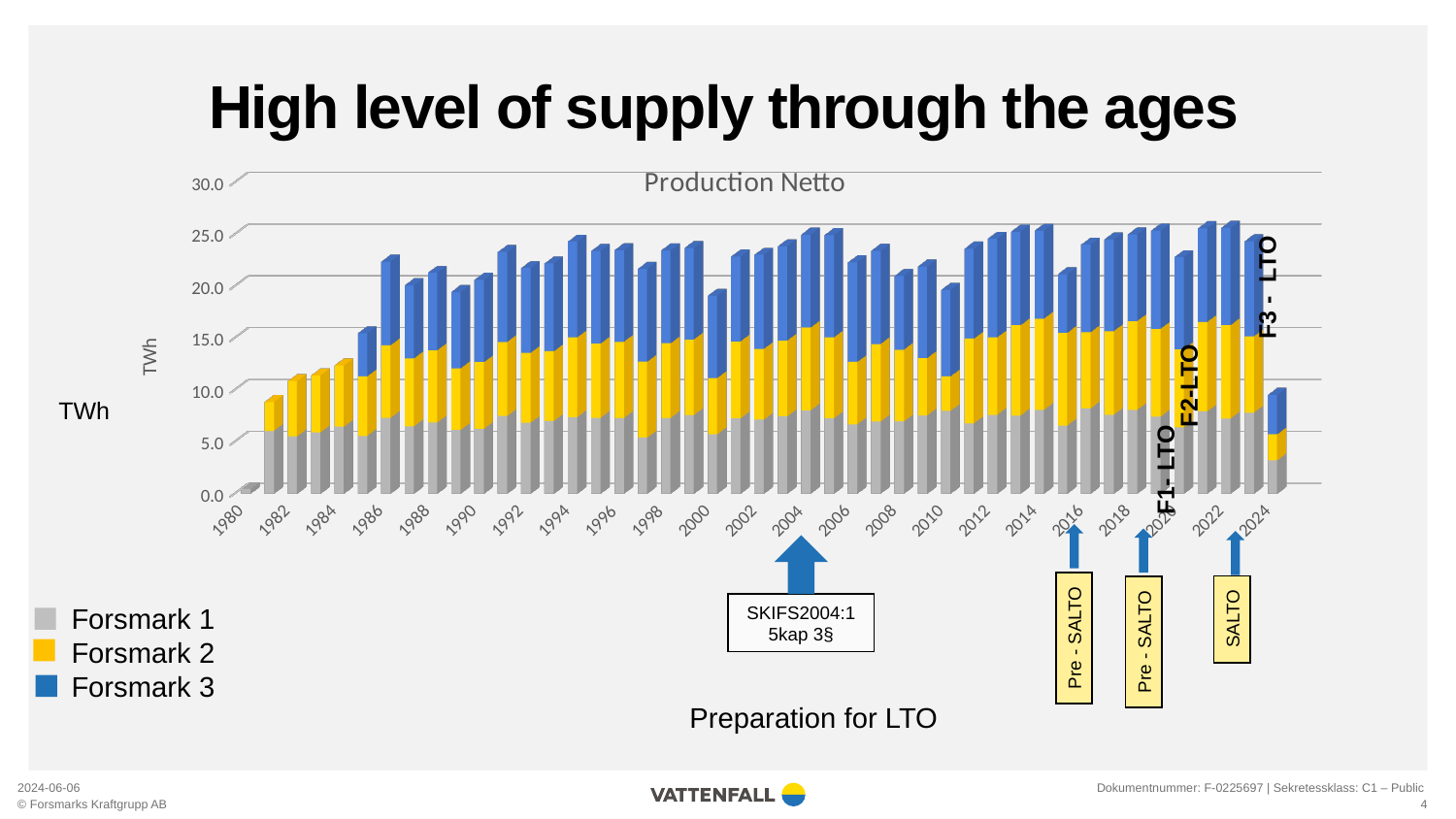
What kind of chart is shown on the slide? stacked bar chart Is the total value for 2005 greater or less than 20? greater What is the title of the chart? Production Netto Is the total value for 2000 greater or less than 20? less Which year has the larger total production, 2000 or 2005? 2005 Do the total values rise or fall from 1981 to 1987? rise How many series does the legend list? 3 Which year has the larger total production, 1981 or 1987? 1987 Is the total value for 1981 greater or less than 15? less What unit is shown on the y axis of the chart? TWh